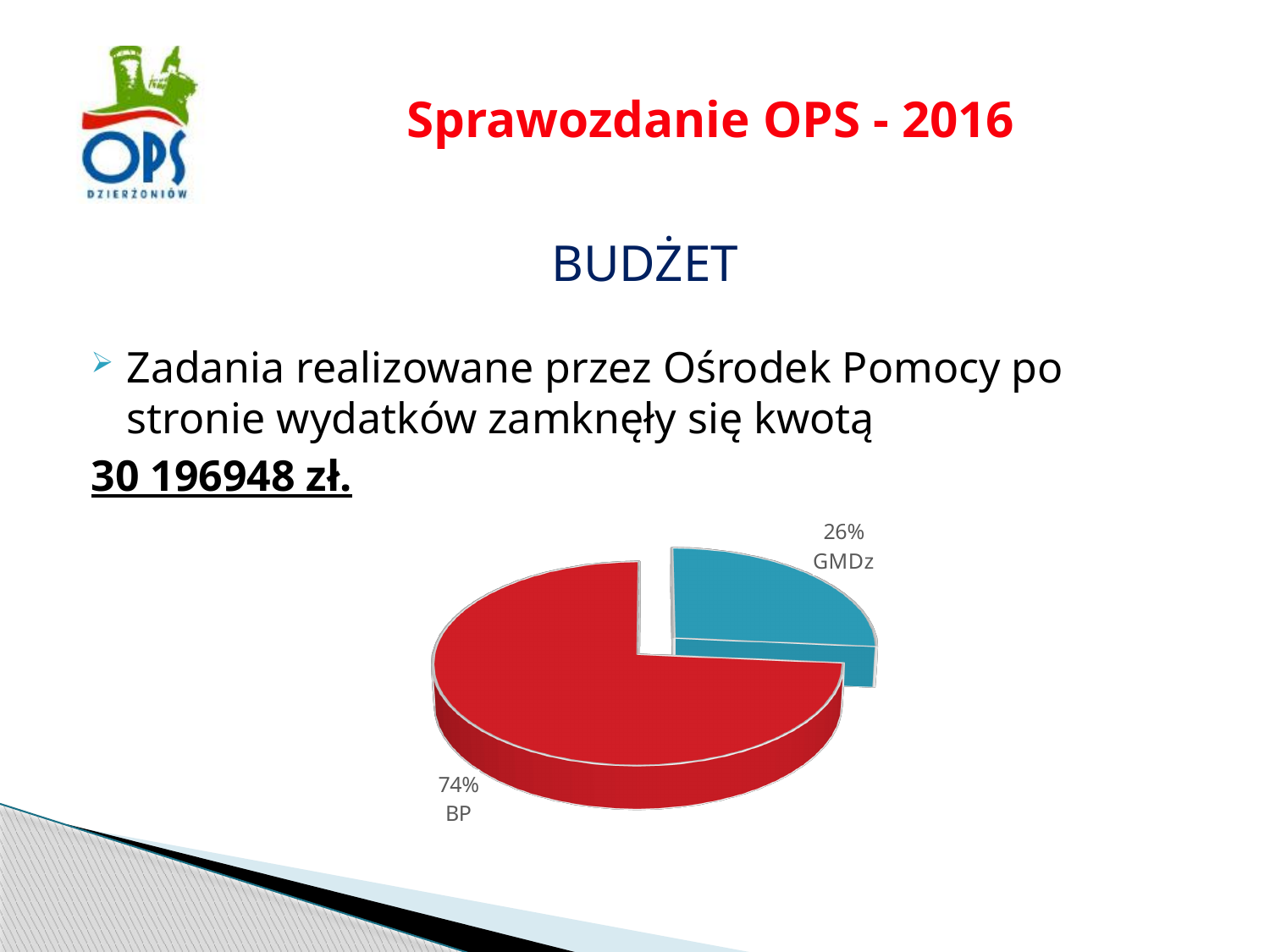
What colour is the GMDz slice of the pie? blue Which slice of the pie is the smallest? GMDz Which slice of the pie is the largest? BP What kind of chart is shown on the slide? pie chart How many slices does the pie chart have? 2 What share of the pie does the BP slice represent? 74% What colour is the BP slice of the pie? red What is the difference in percentage points between the BP and GMDz slices? 48 What share of the pie does the GMDz slice represent? 26% Which is larger, the BP slice or the GMDz slice? BP Is the share for GMDz greater or less than 50%? less